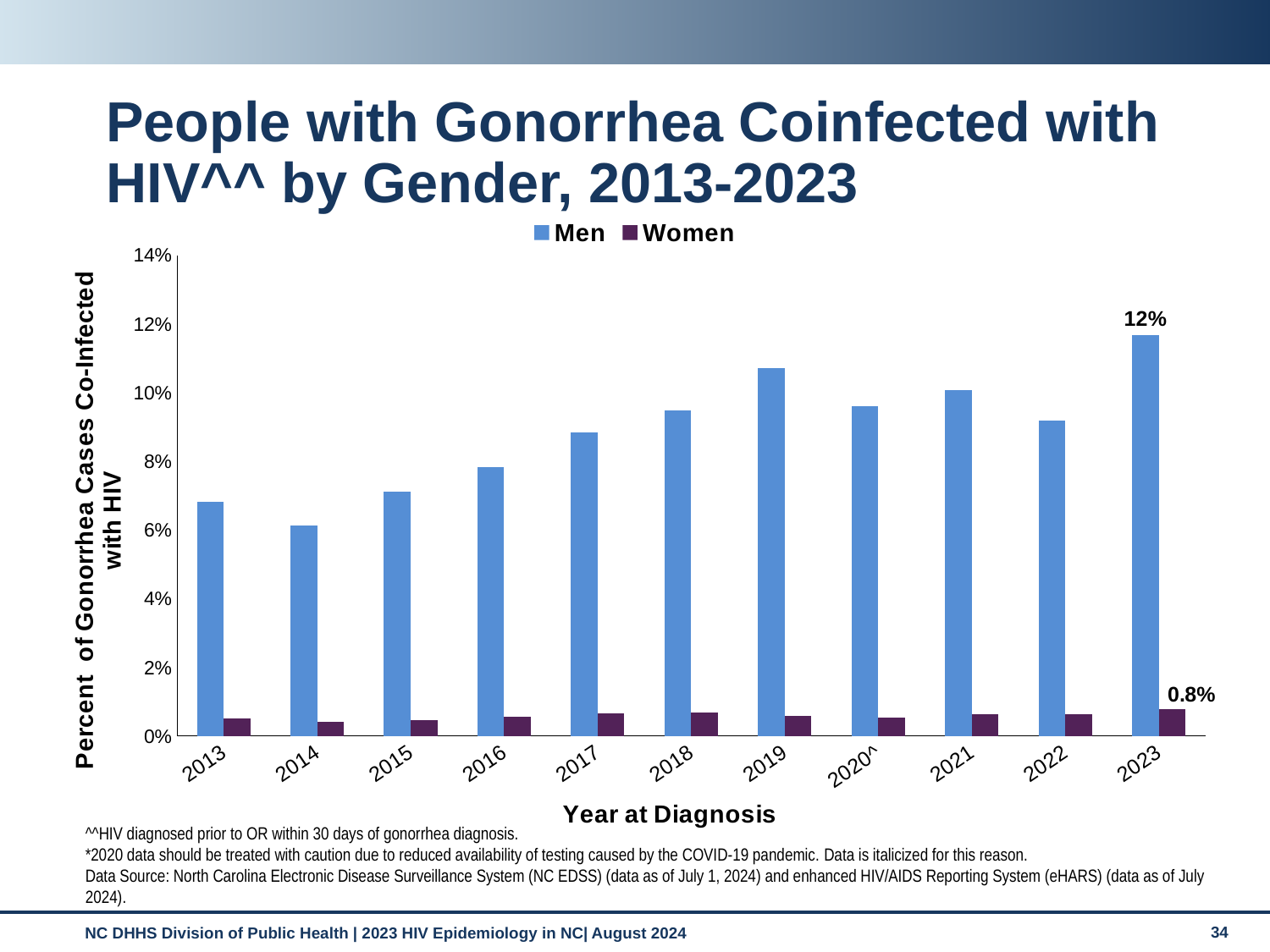
Is the value for Men in 2014 greater or less than 8%? less In which year is the Men series highest? 2023 What is the value for Men in 2023? 12% What is the difference between the Men and Women values in 2023? 11.2% What kind of chart is shown on the slide? Bar chart Which is larger for Men: the value in 2019 or the value in 2022? 2019 How many years are shown on the x axis? 11 What is the value for Women in 2023? 0.8% How many series does the legend list? 2 What is the title of the x axis? Year at Diagnosis In which year is the Men series lowest? 2014 Is the value for Men in 2019 greater or less than 10%? greater